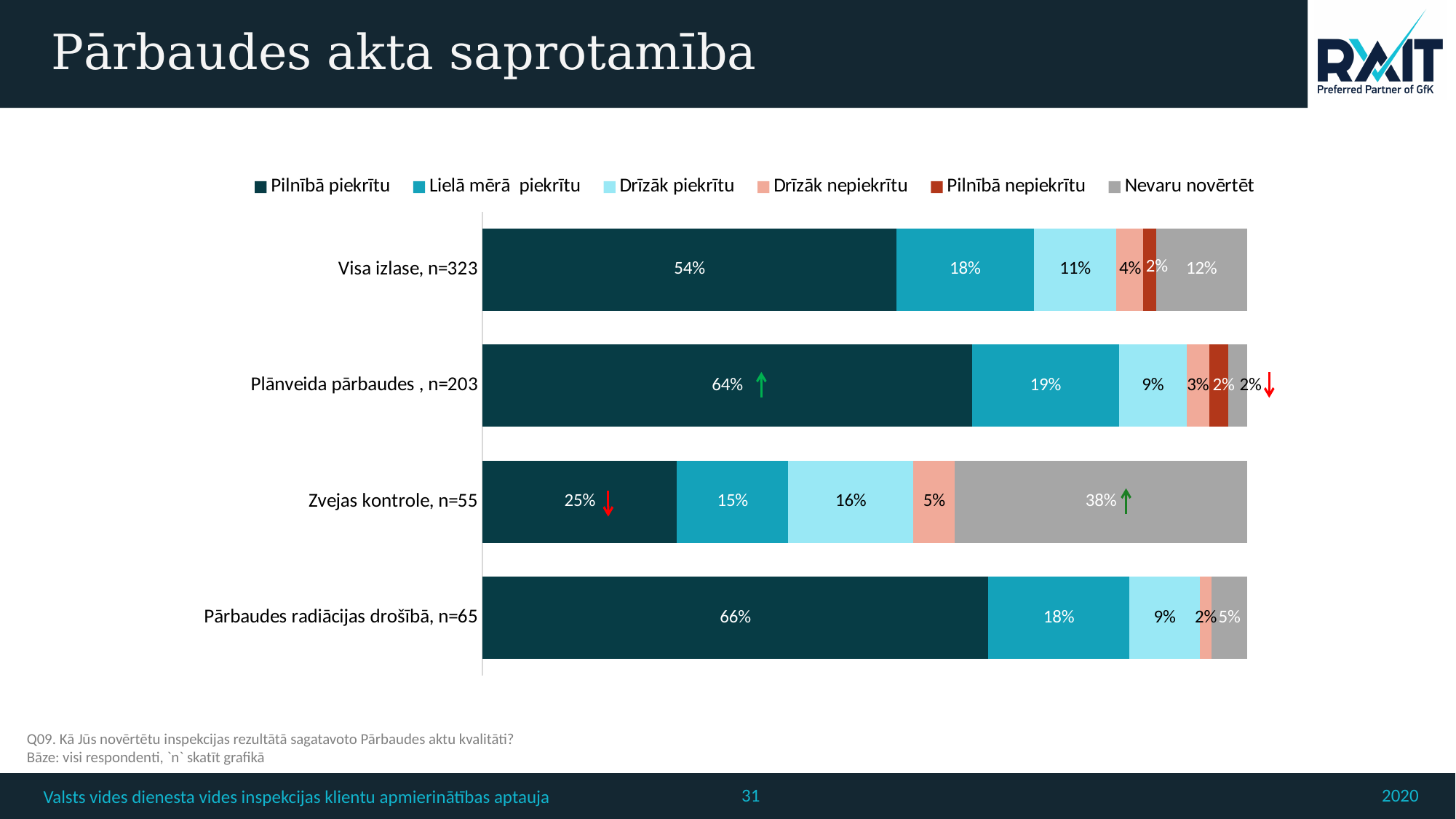
What kind of chart is shown on the slide? Stacked bar chart What is the 'Nevaru novērtēt' value for 'Zvejas kontrole, n=55'? 38% Which is larger: the 'Nevaru novērtēt' value for 'Visa izlase, n=323' or for 'Pārbaudes radiācijas drošībā, n=65'? Visa izlase, n=323 What is the 'Drīzāk piekrītu' value for 'Pārbaudes radiācijas drošībā, n=65'? 9% Which category has the lowest 'Pilnībā piekrītu' value? Zvejas kontrole, n=55 What is the 'Pilnībā piekrītu' value for 'Visa izlase, n=323'? 54% How many categories (rows) are plotted in the chart? 4 How many series does the legend list? 6 Which legend entry is shown in grey? Nevaru novērtēt What is the difference between the 'Pilnībā piekrītu' values for 'Plānveida pārbaudes , n=203' and 'Zvejas kontrole, n=55'? 39% Which category has the highest 'Pilnībā piekrītu' value? Pārbaudes radiācijas drošībā, n=65 What is the 'Lielā mērā piekrītu' value for 'Plānveida pārbaudes , n=203'? 19%